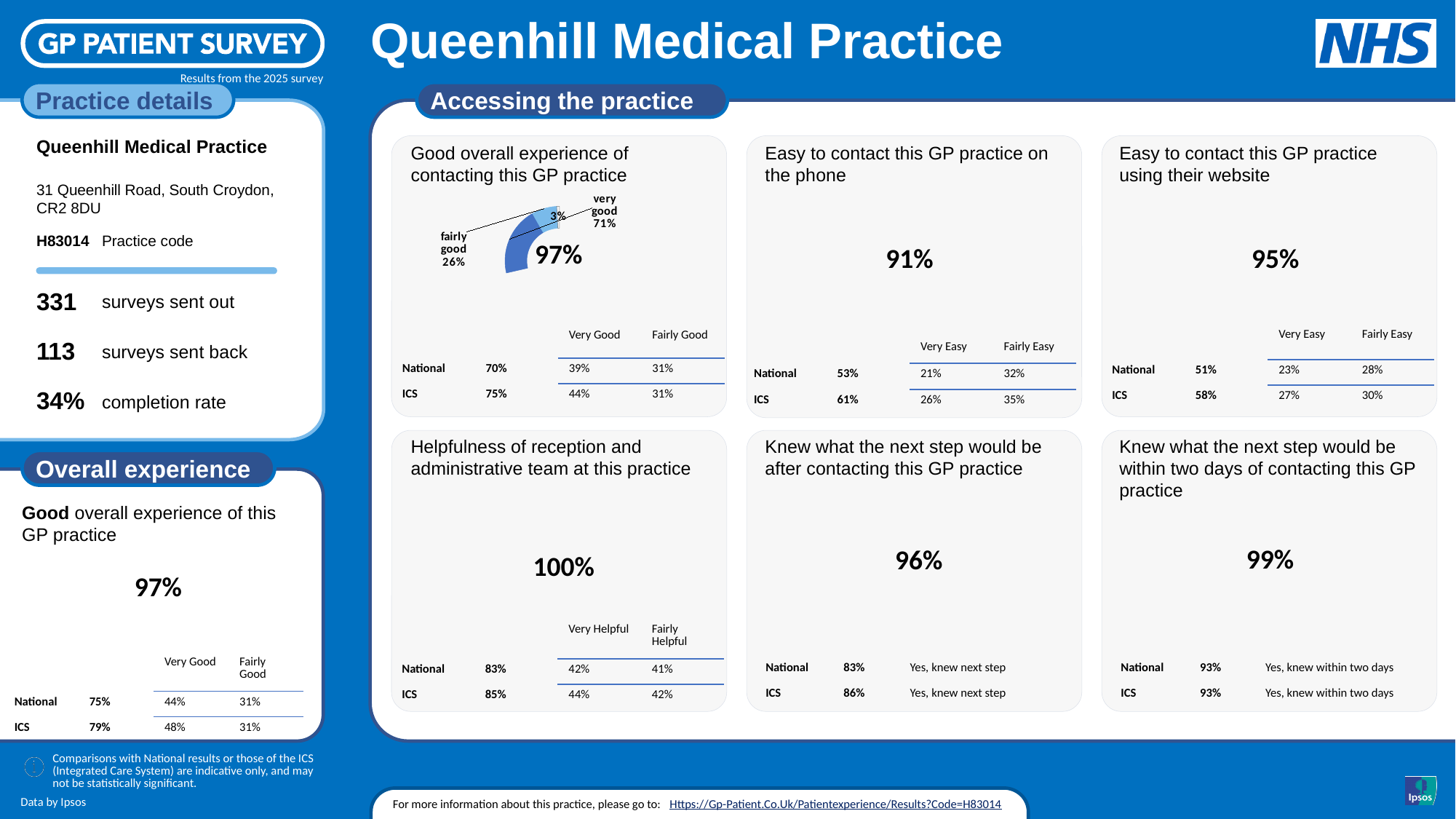
What is the title of the panel containing the doughnut chart on the slide? Good overall experience of contacting this GP practice What kind of chart is used in the 'Good overall experience of contacting this GP practice' panel? doughnut (pie) chart How many slices have percentage labels on the 'Good overall experience of contacting this GP practice' chart? 3 On the 'Good overall experience of contacting this GP practice' chart, which is larger, 'very good' or 'fairly good'? very good On the 'Good overall experience of contacting this GP practice' chart, what is the combined share of the 'very good' and 'fairly good' slices? 97% On the 'Good overall experience of contacting this GP practice' chart, what percentage is shown for 'very good'? 71% On the 'Good overall experience of contacting this GP practice' chart, what is the smallest percentage value shown on a slice? 3% On the 'Good overall experience of contacting this GP practice' chart, what is the difference between the 'very good' and 'fairly good' percentages? 45% On the 'Good overall experience of contacting this GP practice' chart, what percentage is shown for 'fairly good'? 26% On the 'Good overall experience of contacting this GP practice' chart, what combined percentage is printed in the centre of the chart? 97% On the 'Good overall experience of contacting this GP practice' chart, which labelled slice is the largest? very good On the 'Good overall experience of contacting this GP practice' chart, is the 'very good' slice greater or less than 50%? greater